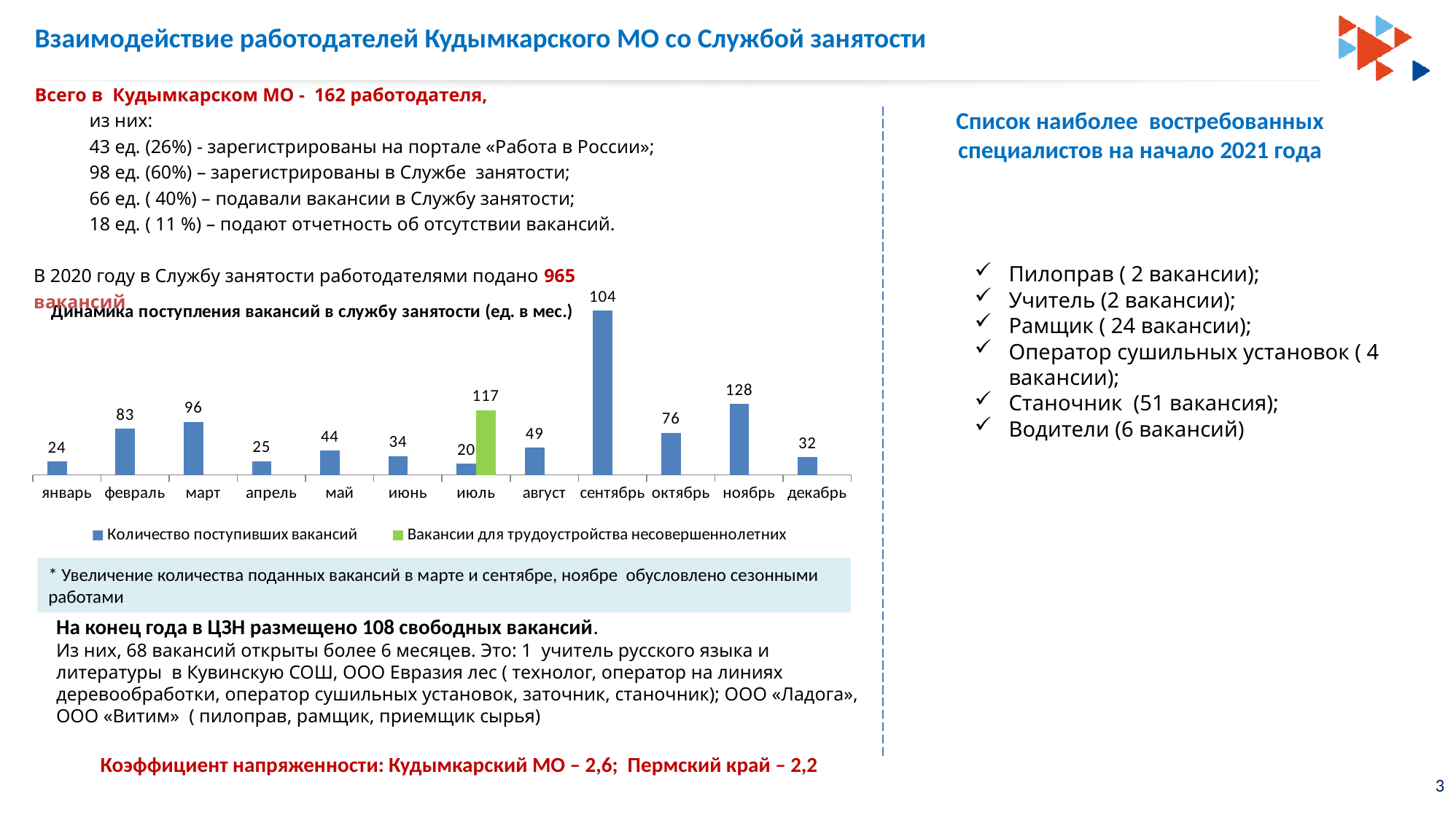
What colour are the bars for 'Вакансии для трудоустройства несовершеннолетних'? green What is the value of 'Вакансии для трудоустройства несовершеннолетних' for июль? 117 Which month has the lowest value for 'Количество поступивших вакансий'? июль What is the value of 'Количество поступивших вакансий' for ноябрь? 128 How many months are shown on the x axis of the vacancies chart? 12 How many series does the legend of the vacancies chart list? 2 What type of chart is used to show the dynamics of vacancies received by the employment service? bar chart Do the 'Количество поступивших вакансий' values rise or fall from январь to март? rise What is the value of 'Количество поступивших вакансий' for сентябрь? 104 Which is larger, the 'Количество поступивших вакансий' value for март or for октябрь? март